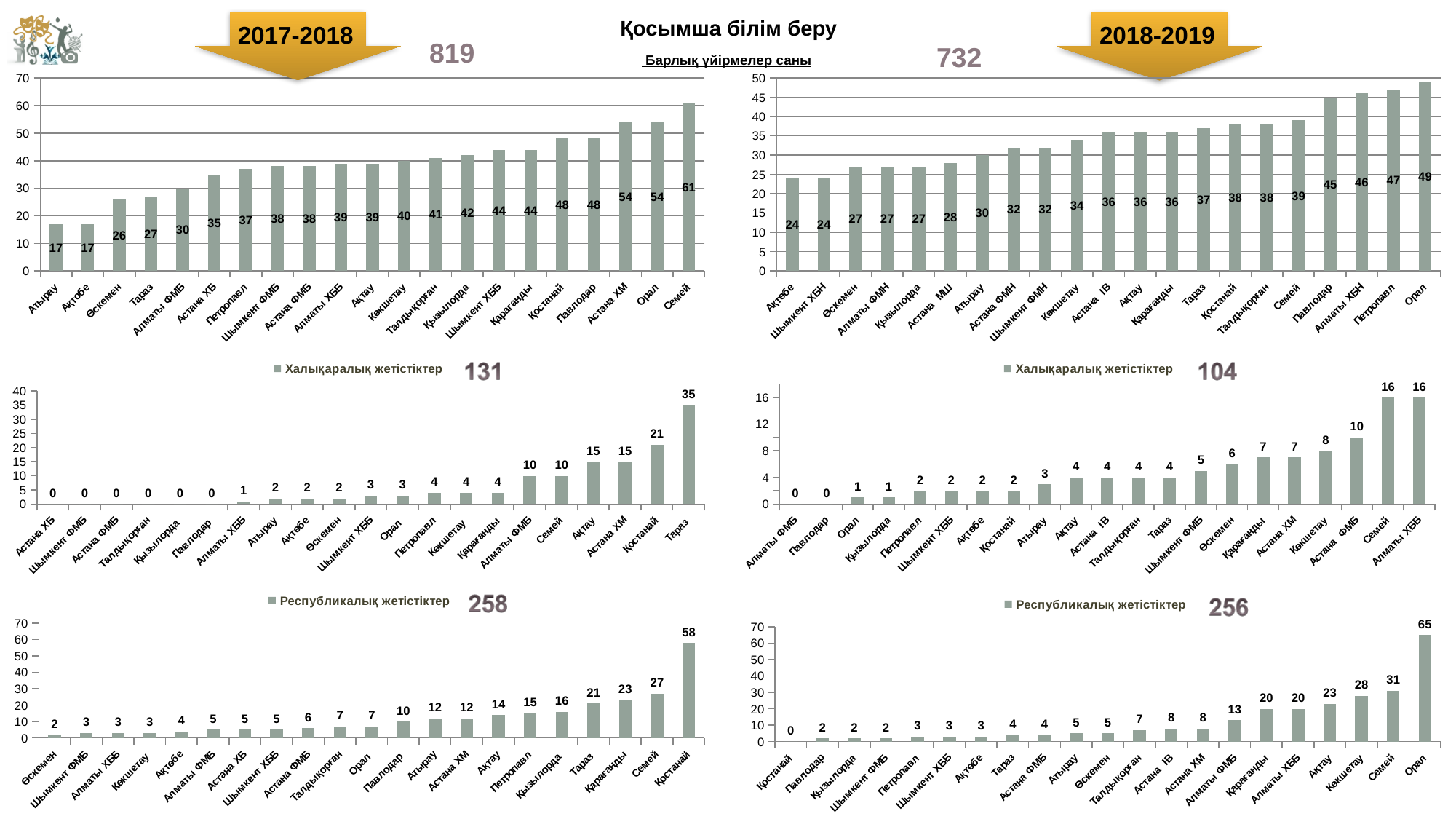
In the middle-left chart (Халықаралық жетістіктер, 2017-2018), what is the value for Қостанай? 21 In the middle-left chart (Халықаралық жетістіктер, 2017-2018), which category has the highest value? Тараз In the top-right chart (2018-2019, Барлық үйірмелер саны), which category has the highest value? Орал In the top-left chart (2017-2018, Барлық үйірмелер саны), what is the value for Семей? 61 How many categories are shown in the top-left chart (2017-2018, Барлық үйірмелер саны)? 21 In the bottom-right chart (Республикалық жетістіктер, 2018-2019), what is the value for Орал? 65 In the bottom-left chart (Республикалық жетістіктер, 2017-2018), which is larger, the value for Семей or the value for Қостанай? Қостанай In the top-left chart (2017-2018, Барлық үйірмелер саны), what is the difference between the values for Семей and Атырау? 44 In the middle-right chart (Халықаралық жетістіктер, 2018-2019), what is the value for Астана ФМБ? 10 What kind of chart is the bottom-left chart (Республикалық жетістіктер, 2017-2018)? Bar chart In the bottom-right chart (Республикалық жетістіктер, 2018-2019), what is the difference between the values for Орал and Семей? 34 In the top-right chart (2018-2019, Барлық үйірмелер саны), what is the value for Павлодар? 45